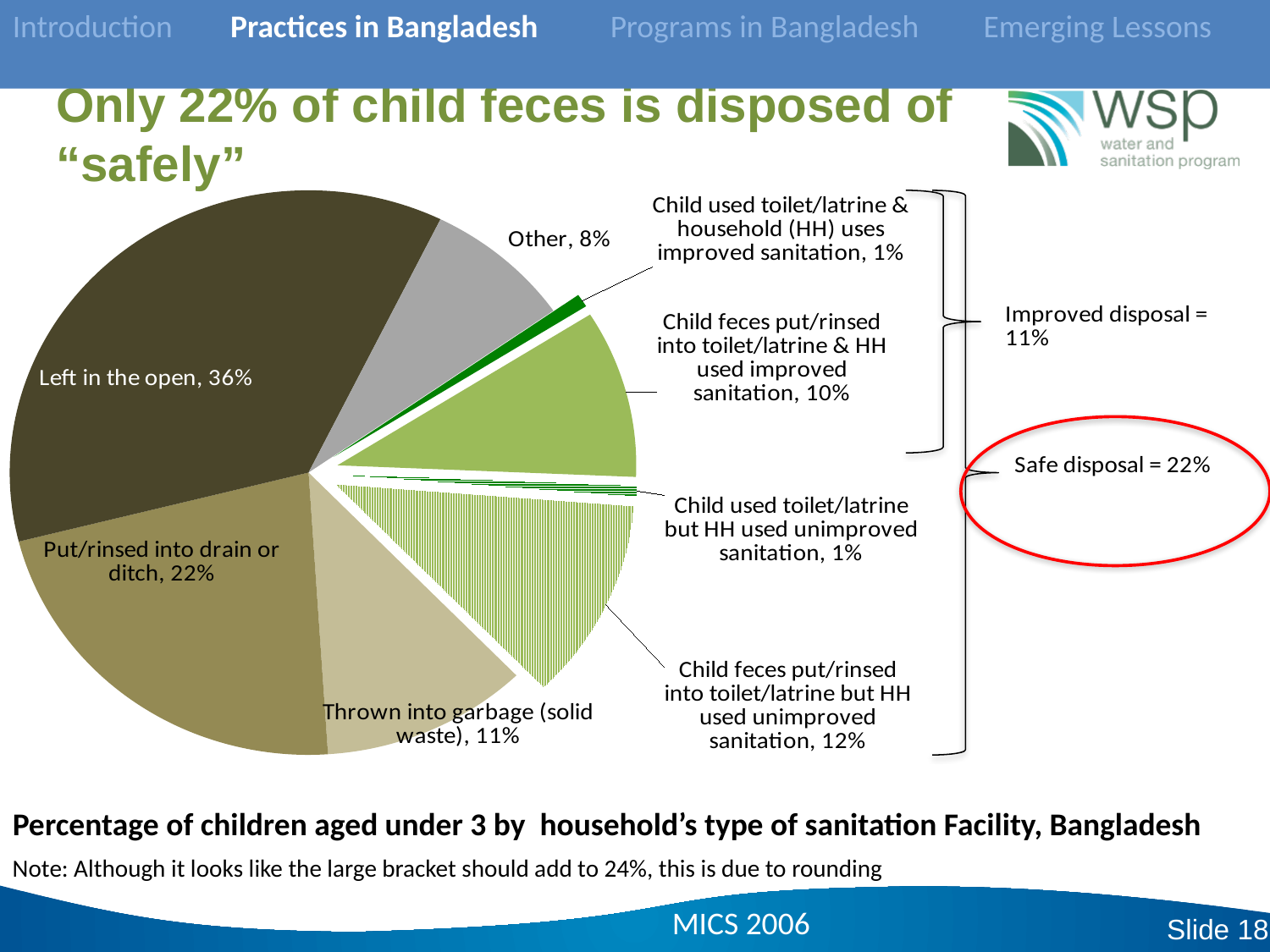
What percentage of child feces is left in the open? 36% According to the annotation on the chart, what is the total for improved disposal? 11% Which category has the largest share of the pie? Left in the open What percentage corresponds to child feces put/rinsed into toilet/latrine but HH used unimproved sanitation? 12% How many slices does the pie chart have? 8 What percentage of child feces is put/rinsed into a drain or ditch? 22% What is the value of the 'Other' slice? 8% What percentage of child feces is thrown into garbage (solid waste)? 11% What kind of chart is shown on the slide? Pie chart What is the difference between the 'Left in the open' share and the 'Put/rinsed into drain or ditch' share? 14% According to the circled annotation on the chart, what is the total for safe disposal? 22% Which is larger: 'Thrown into garbage (solid waste)' or 'Other'? Thrown into garbage (solid waste)